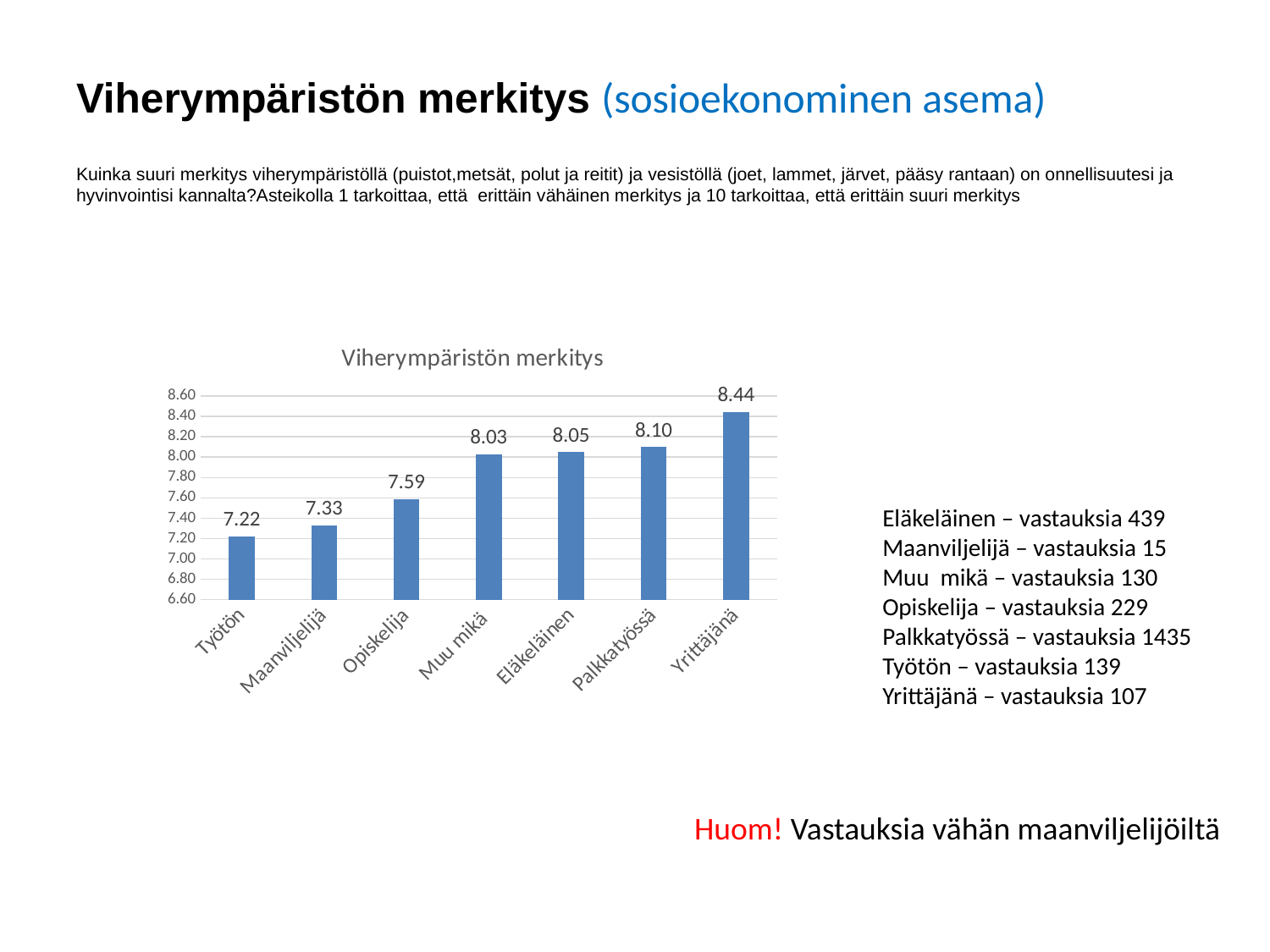
Which category has the lowest value in the chart? Työtön What is the value for Työtön in the chart? 7.22 Is the value for Eläkeläinen greater or less than 7.60? greater What is the title of the chart? Viherympäristön merkitys What is the value for Opiskelija in the chart? 7.59 What is the value for Yrittäjänä in the chart? 8.44 How many categories are shown in the chart? 7 What is the difference between the values for Yrittäjänä and Työtön? 1.22 What is the difference between the values for Palkkatyössä and Opiskelija? 0.51 Which category has the highest value in the chart? Yrittäjänä What kind of chart is shown on the slide? bar chart Which is larger, the value for Maanviljelijä or the value for Muu mikä? Muu mikä